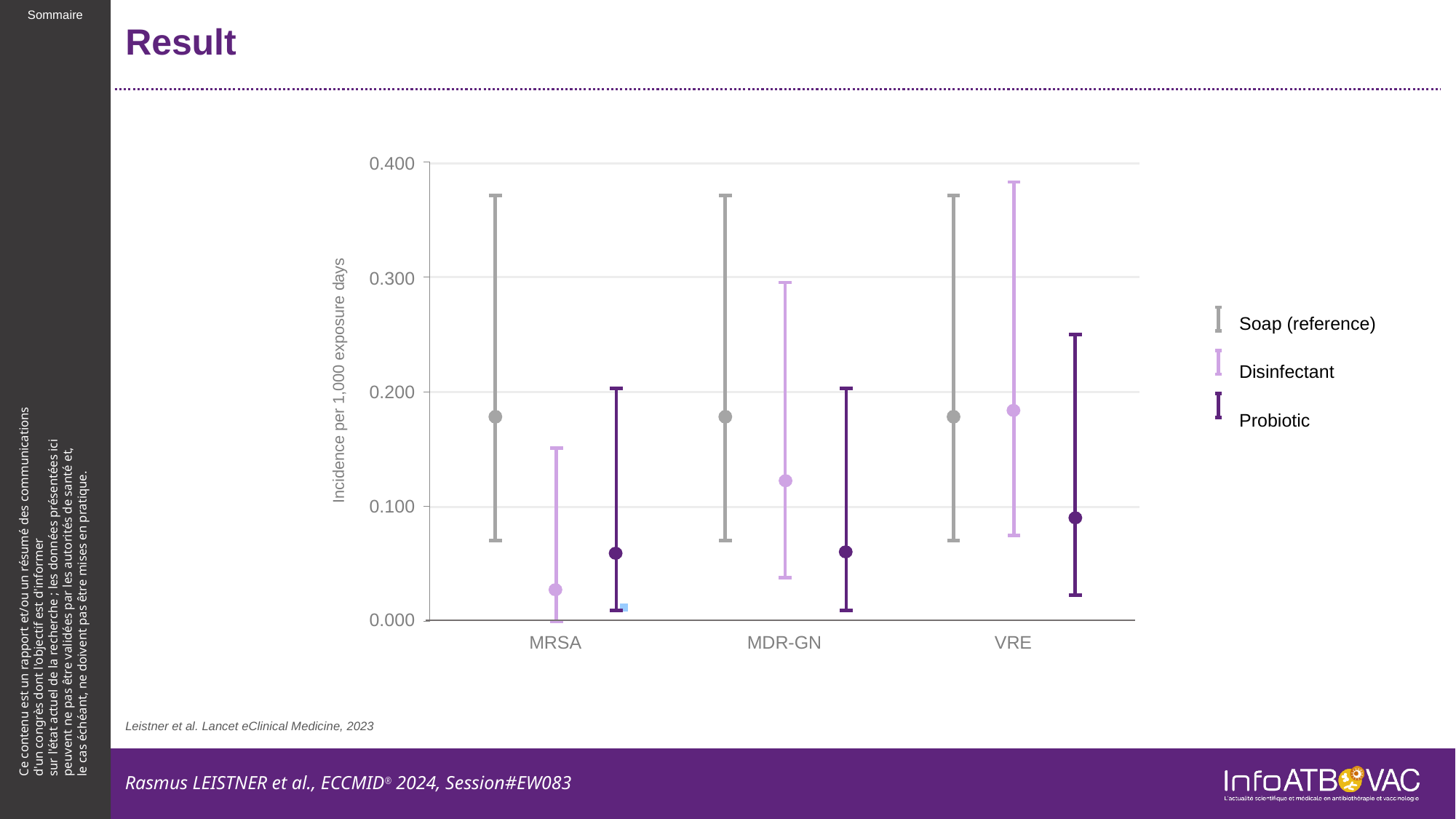
How many categories are shown on the x axis? 3 For MDR-GN, which is larger: the Disinfectant value or the Probiotic value? Disinfectant For MRSA, which is larger: the Soap (reference) value or the Disinfectant value? Soap (reference) Is the Probiotic value for MDR-GN greater or less than 0.100? less How many series does the legend list? 3 Is the Soap (reference) value for MRSA greater or less than 0.100? greater Which series is shown in grey in the legend? Soap (reference) What is the y-axis title of the chart? Incidence per 1,000 exposure days Is the Disinfectant value for VRE greater or less than 0.100? greater For which category is the Disinfectant value highest? VRE What type of chart is shown on the slide? Scatter chart with error bars